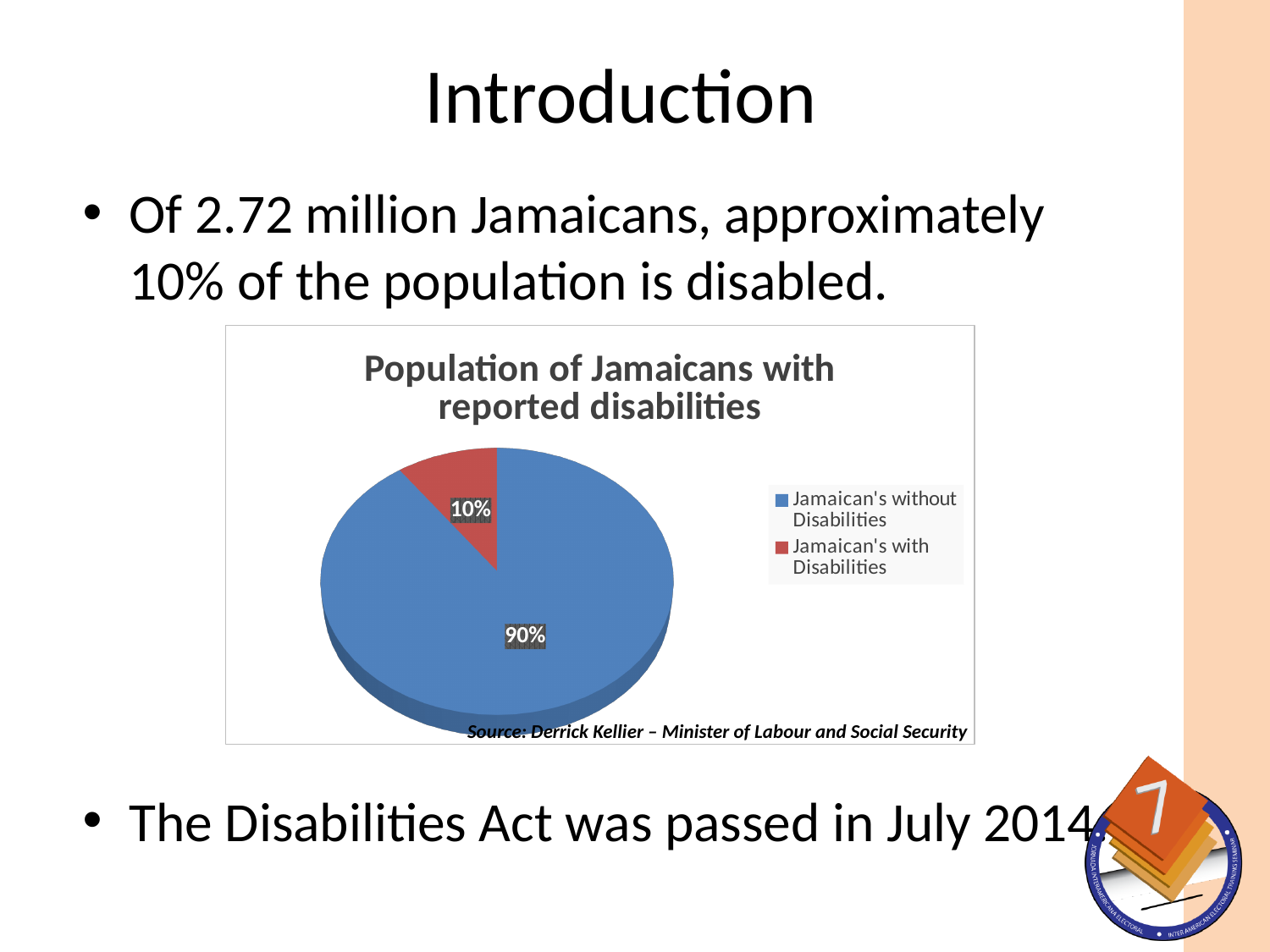
What share of the pie is labelled for Jamaican's with Disabilities? 10% What is the title of the chart? Population of Jamaicans with reported disabilities What is the difference in percentage points between the Jamaican's without Disabilities slice and the Jamaican's with Disabilities slice? 80 What kind of chart is shown on the slide? Pie chart What colour is the slice for Jamaican's with Disabilities? Red What share of the pie is labelled for Jamaican's without Disabilities? 90% Which slice of the pie is the largest? Jamaican's without Disabilities Which slice of the pie is the smallest? Jamaican's with Disabilities Which is larger: the share for Jamaican's with Disabilities or the share for Jamaican's without Disabilities? Jamaican's without Disabilities How many entries does the legend list? 2 How many slices does the pie chart have? 2